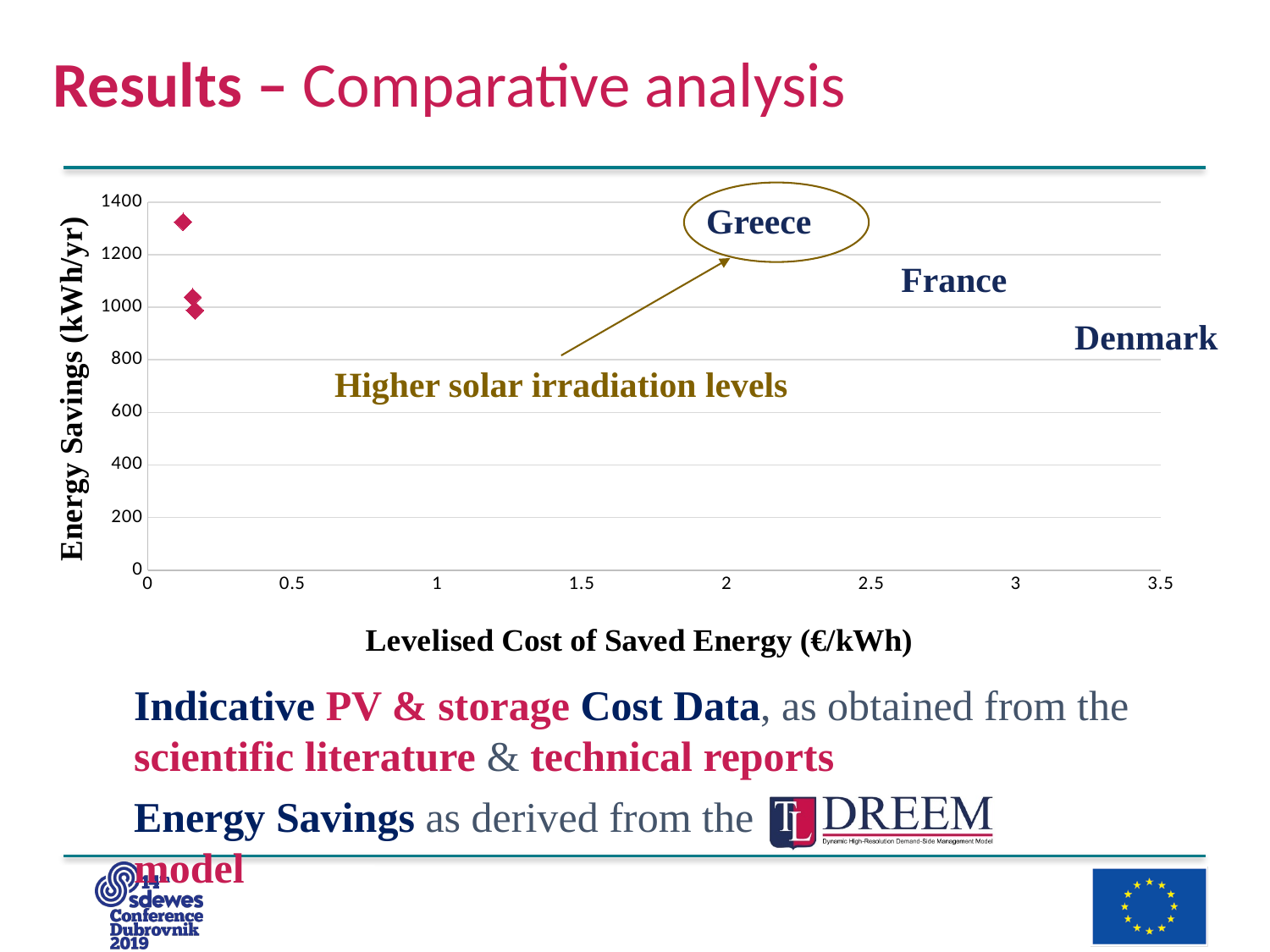
What is the maximum value shown on the y axis? 1400 What kind of chart is shown on the slide? scatter chart Are all plotted points at a levelised cost of saved energy greater or less than 0.5 €/kWh? less What is the title of the x axis? Levelised Cost of Saved Energy (€/kWh) How many plotted points have energy savings below 1200 kWh/yr? 2 Is the energy savings value of the highest plotted point greater or less than 1200 kWh/yr? greater Is the energy savings value of the lowest plotted point greater or less than 800 kWh/yr? greater How many data points are plotted on the chart? 3 How many plotted points have energy savings above 1200 kWh/yr? 1 What is the maximum value shown on the x axis? 3.5